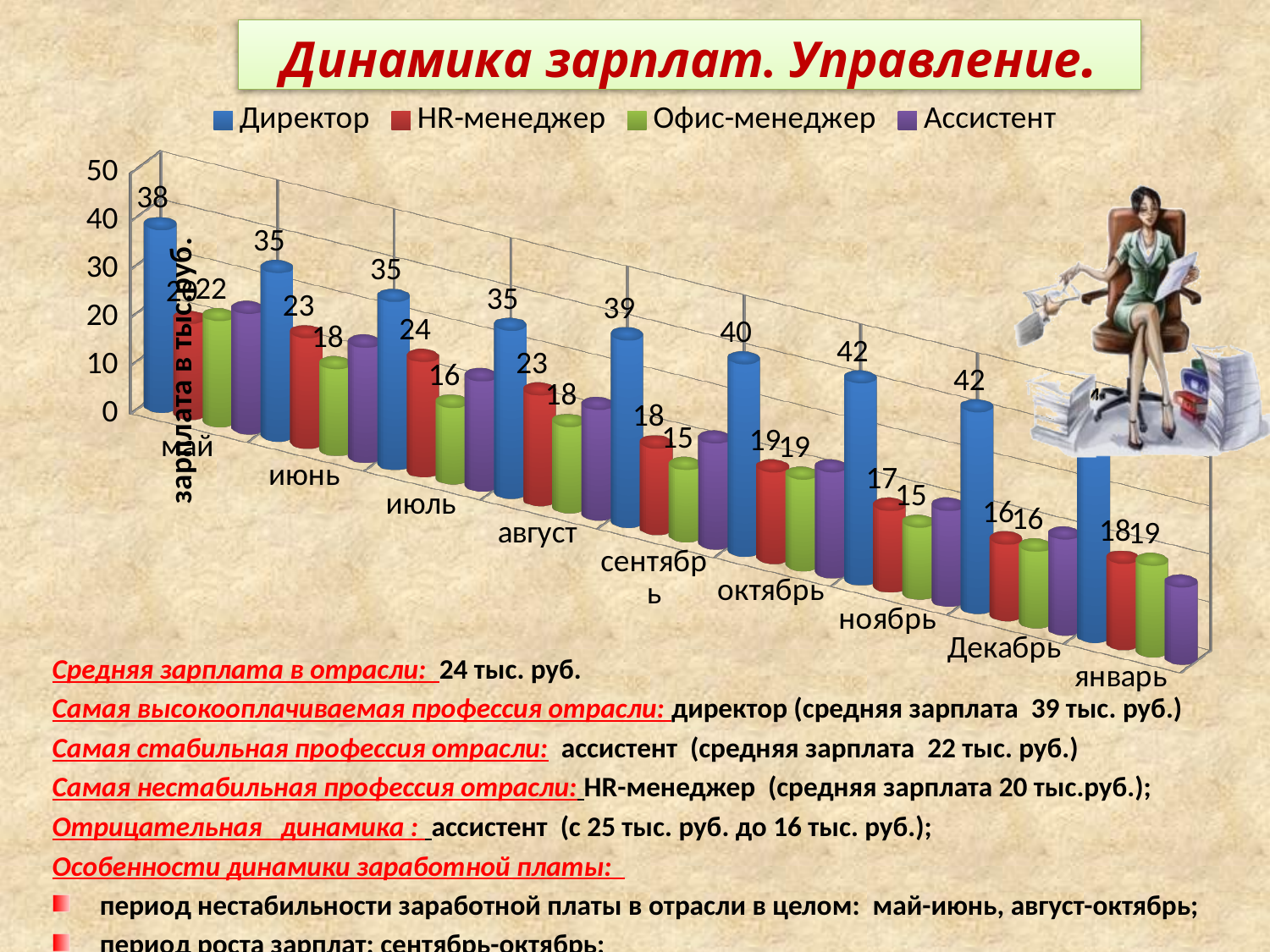
What is the value for Директор in ноябрь? 42 What is the difference between Директор and HR-менеджер in ноябрь? 25 What is the value for Офис-менеджер in сентябрь? 15 What is the value for HR-менеджер in июль? 24 What kind of chart is shown on the slide? bar chart What is the label on the vertical axis? зарплата в тыс. руб. Do the values for Директор rise or fall from август to ноябрь? rise How many series does the legend list? 4 Which is larger in июль, HR-менеджер or Офис-менеджер? HR-менеджер What is the value for Директор in май? 38 How many months are shown on the x axis? 9 What is the difference between Директор and HR-менеджер in сентябрь? 21